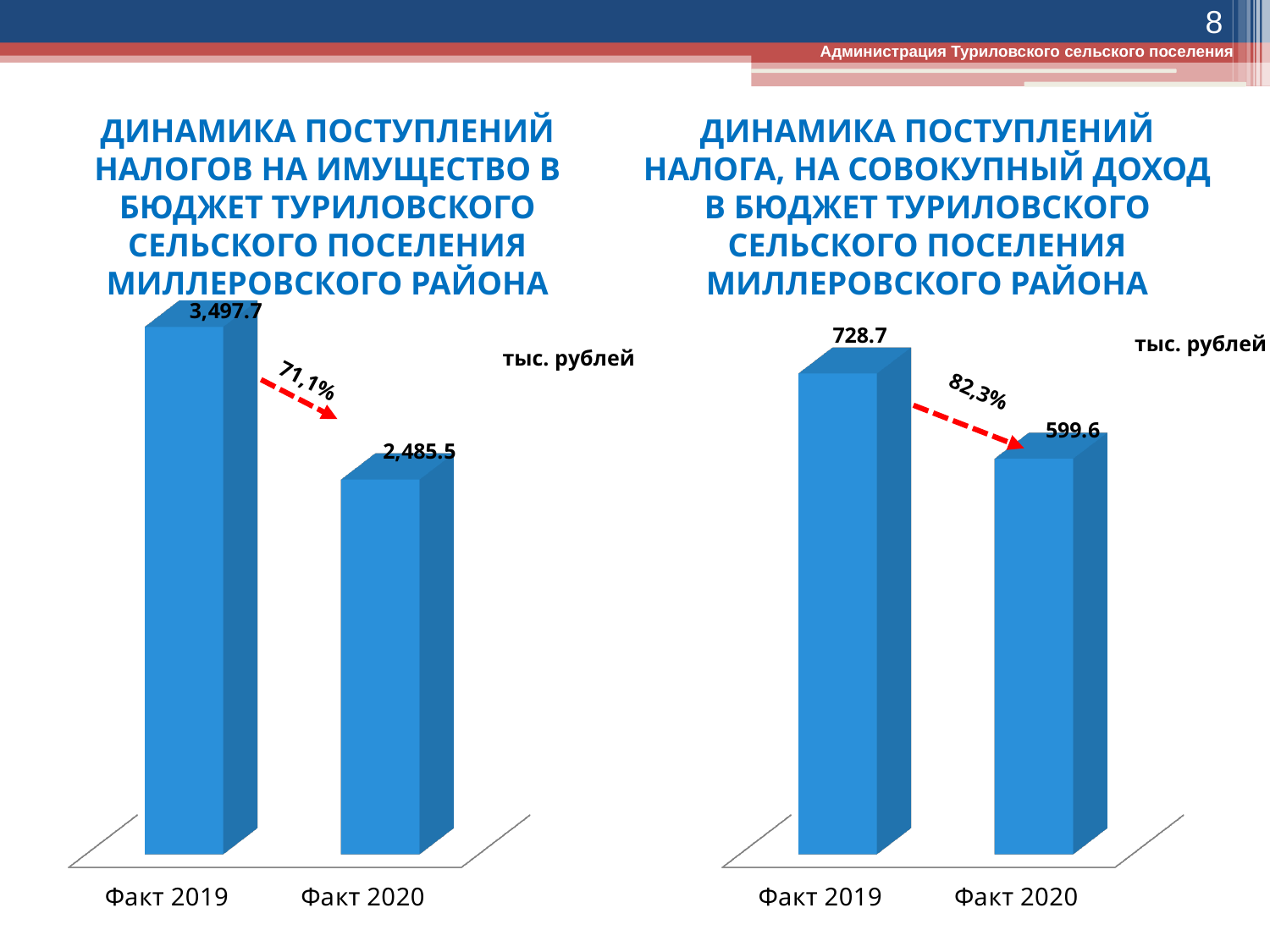
What percentage is shown on the arrow in the left chart (property taxes)? 71,1% How many categories are shown in the left chart (property taxes)? 2 In the right chart (aggregate income tax), do the values rise or fall from Факт 2019 to Факт 2020? fall In the left chart (property taxes), what is the value for Факт 2019? 3,497.7 In the left chart (property taxes), which category has the higher value? Факт 2019 What type of chart is the right chart (aggregate income tax)? bar chart In the right chart (aggregate income tax), what is the value for Факт 2019? 728.7 In the right chart (aggregate income tax), which category has the lower value? Факт 2020 In the right chart (aggregate income tax), what is the value for Факт 2020? 599.6 In the left chart (property taxes), what is the value for Факт 2020? 2,485.5 In the left chart (property taxes), what is the difference between Факт 2019 and Факт 2020? 1,012.2 In the right chart (aggregate income tax), what is the difference between Факт 2019 and Факт 2020? 129.1